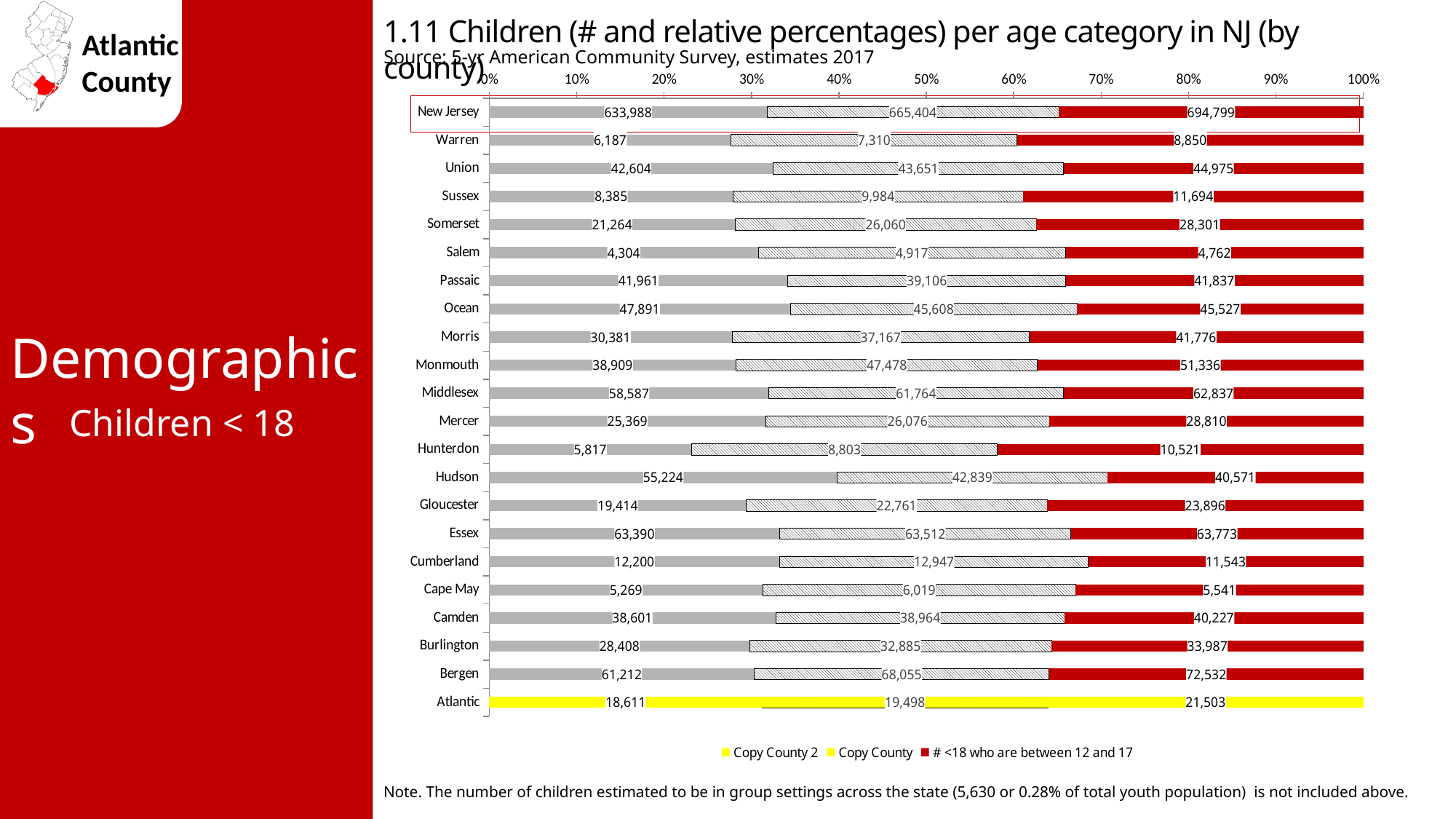
What is the total of the three segments for Atlantic? 59,612 What is the difference between the third segment (21,503) and the first segment (18,611) for Atlantic? 2,892 Which is larger: the first segment for Hudson or the first segment for Bergen? Bergen What type of chart is shown on the slide? Stacked bar chart What is the value of the '# <18 who are between 12 and 17' segment for Bergen? 72,532 What is the value of the '# <18 who are between 12 and 17' segment for New Jersey? 694,799 What is the value of the first (leftmost) segment for Atlantic? 18,611 How many categories (rows) are plotted on the chart? 22 Among the counties (excluding New Jersey), which has the lowest value for '# <18 who are between 12 and 17'? Salem Is the share of the first segment for Hudson greater or less than 30%? greater Among the counties (excluding New Jersey), which has the highest value for '# <18 who are between 12 and 17'? Bergen How many series does the legend list? 3